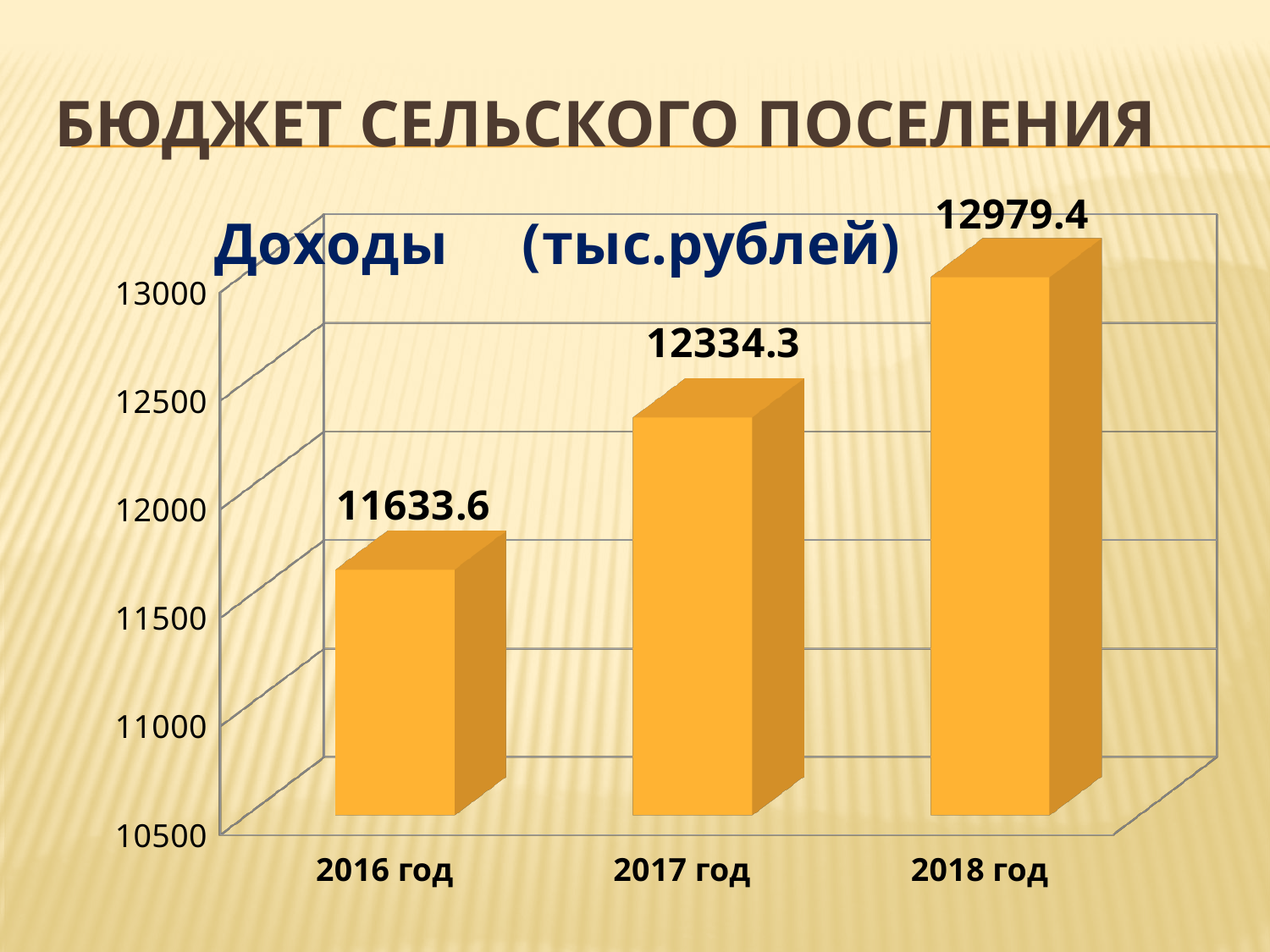
What is the value for 2017 год? 12334.3 Which year has the highest value? 2018 год How many years are shown on the chart? 3 What is the difference between the values for 2017 год and 2016 год? 700.7 What is the value for 2016 год? 11633.6 Which year has the lowest value? 2016 год What kind of chart is shown on the slide? bar chart Is the value for 2016 год greater or less than 12000? less Which is larger, the value for 2016 год or the value for 2017 год? 2017 год Do the values rise or fall from 2016 год to 2018 год? rise What is the difference between the values for 2018 год and 2017 год? 645.1 What is the value for 2018 год? 12979.4